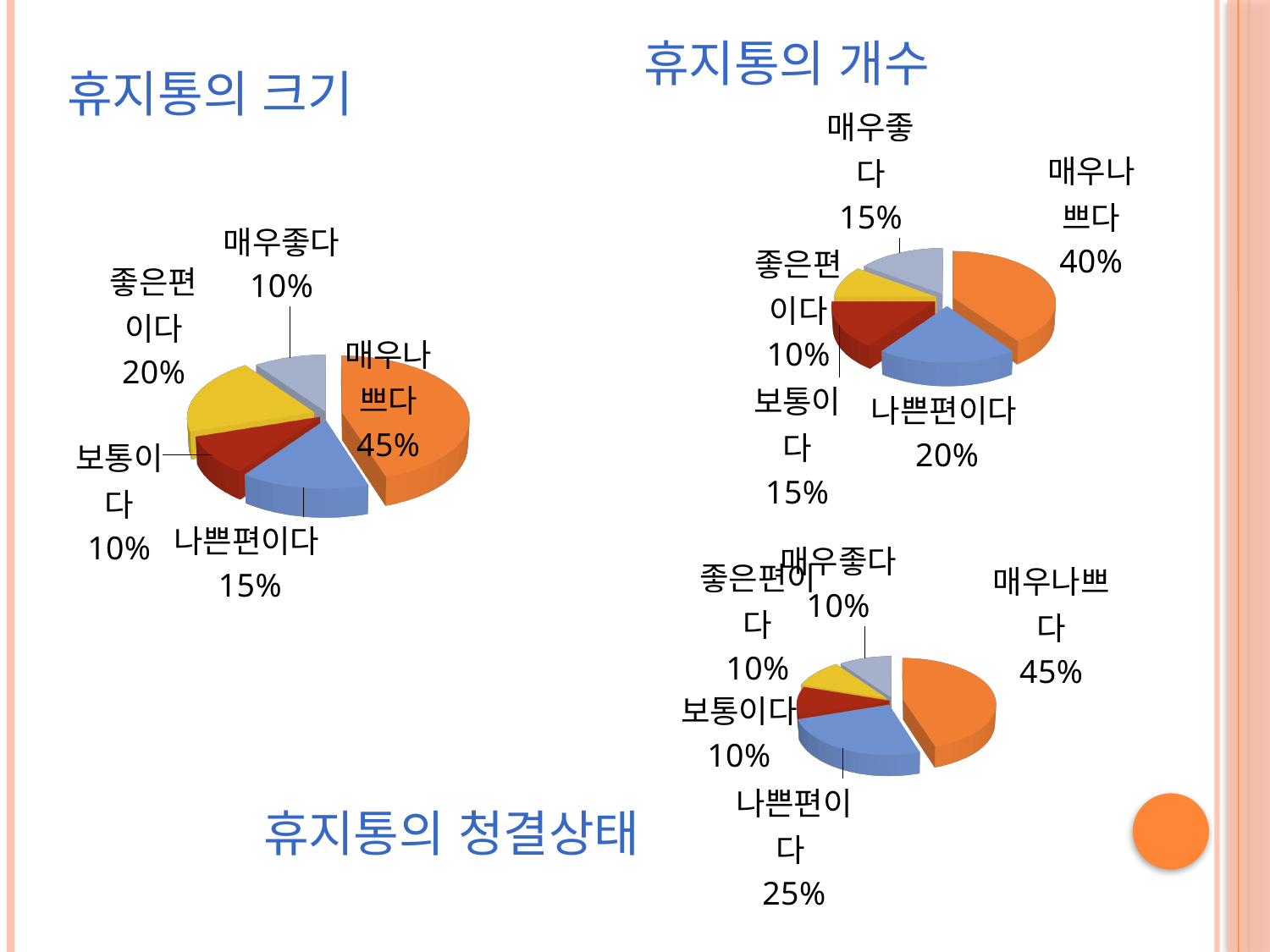
In the '휴지통의 개수' chart, what share does 나쁜편이다 have? 20% In the '휴지통의 크기' chart, what share does 매우나쁘다 have? 45% In the '휴지통의 개수' chart, what is the difference between the shares of 매우나쁘다 and 나쁜편이다? 20% How many charts are shown on the slide? 3 In the '휴지통의 크기' chart, what share does 좋은편이다 have? 20% In the '휴지통의 청결상태' chart, what share does 나쁜편이다 have? 25% In the '휴지통의 크기' chart, which category has the largest share? 매우나쁘다 How many slices does the '휴지통의 청결상태' chart have? 5 What kind of chart is the '휴지통의 크기' chart? Pie chart In the '휴지통의 청결상태' chart, which is larger, 매우나쁘다 or 나쁜편이다? 매우나쁘다 In the '휴지통의 개수' chart, which category has the smallest share? 좋은편이다 In the '휴지통의 개수' chart, what share does 매우나쁘다 have? 40%